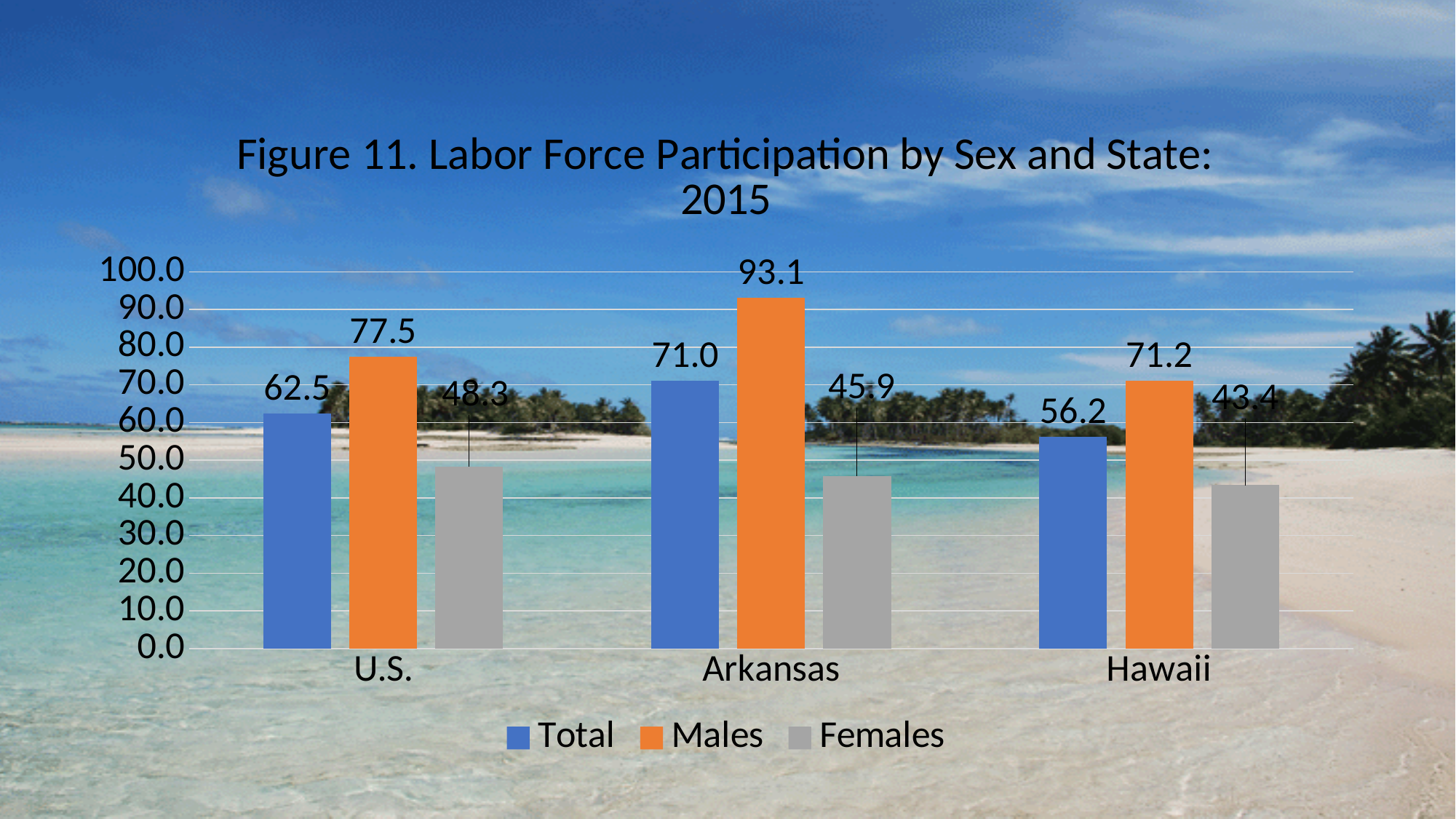
Which state or region has the highest Males value? Arkansas Which is larger, the Females value for the U.S. or the Females value for Arkansas? U.S. What kind of chart is shown on the slide? bar chart How many series does the legend list? 3 Which state or region has the lowest Total value? Hawaii What is the title of the chart? Figure 11. Labor Force Participation by Sex and State: 2015 What is the Males value for Arkansas? 93.1 What is the Females value for Hawaii? 43.4 What is the Total value for the U.S.? 62.5 How many categories are shown on the x axis? 3 Is the Total value for Hawaii greater or less than 60.0? less What is the difference between the Males and Females values for Arkansas? 47.2